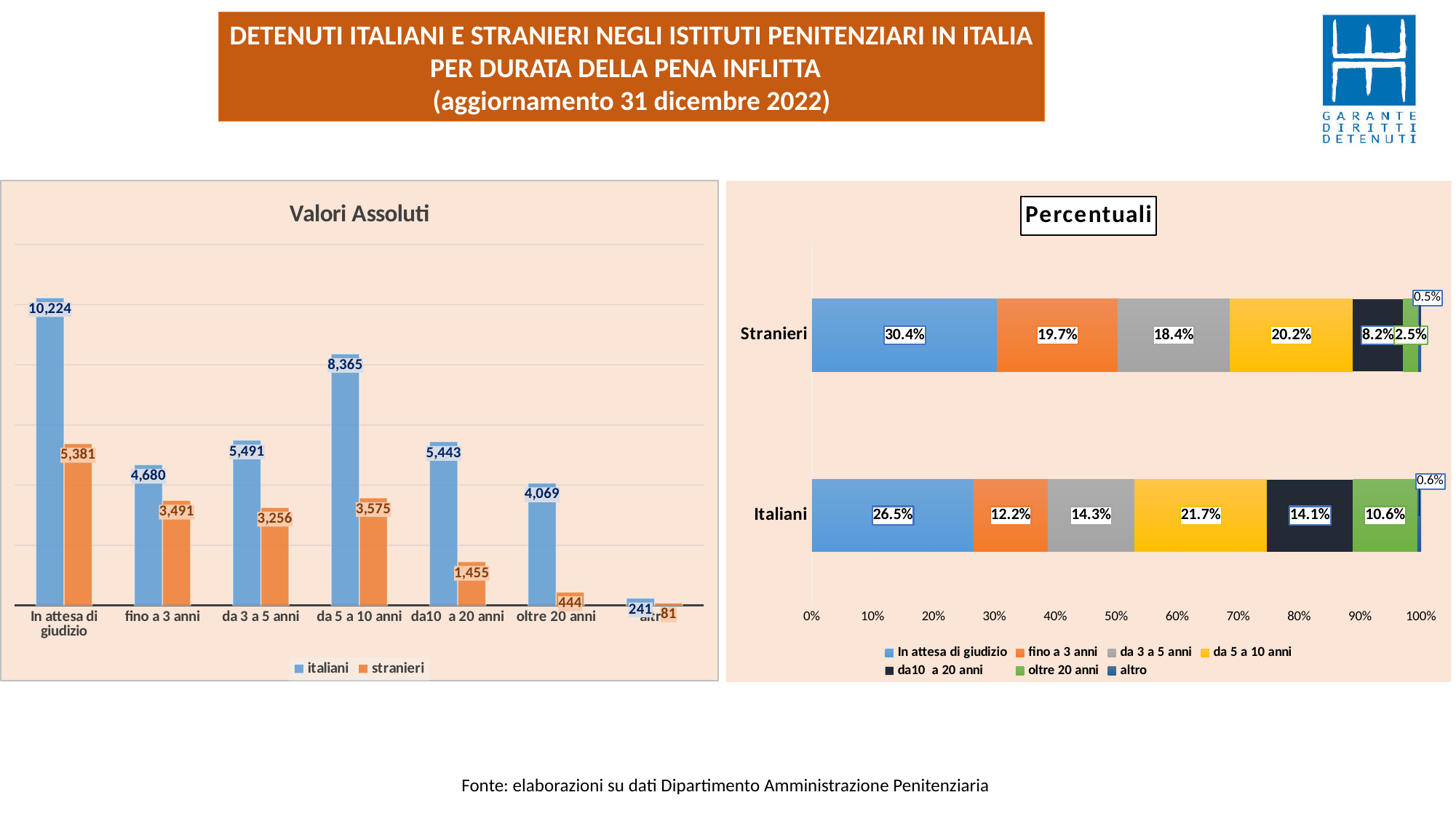
In the 'Percentuali' chart, which is larger: 'oltre 20 anni' for Italiani or 'oltre 20 anni' for Stranieri? Italiani In the 'Valori Assoluti' chart, which category has the highest value for stranieri? In attesa di giudizio What kind of chart is the 'Valori Assoluti' chart? bar chart In the 'Valori Assoluti' chart, which is larger: italiani in 'fino a 3 anni' or italiani in 'oltre 20 anni'? fino a 3 anni How many categories are shown on the x axis of the 'Valori Assoluti' chart? 7 In the 'Percentuali' chart, what is the share of 'In attesa di giudizio' for Stranieri? 30.4% In the 'Valori Assoluti' chart, what is the value for italiani in the 'In attesa di giudizio' category? 10,224 In the 'Valori Assoluti' chart, which category has the lowest value for italiani? altro In the 'Valori Assoluti' chart, what is the difference between italiani and stranieri in the 'da10 a 20 anni' category? 3,988 How many series does the legend of the 'Percentuali' chart list? 7 In the 'Valori Assoluti' chart, what is the value for stranieri in the 'da 5 a 10 anni' category? 3,575 In the 'Percentuali' chart, what is the share of 'da 5 a 10 anni' for Italiani? 21.7%